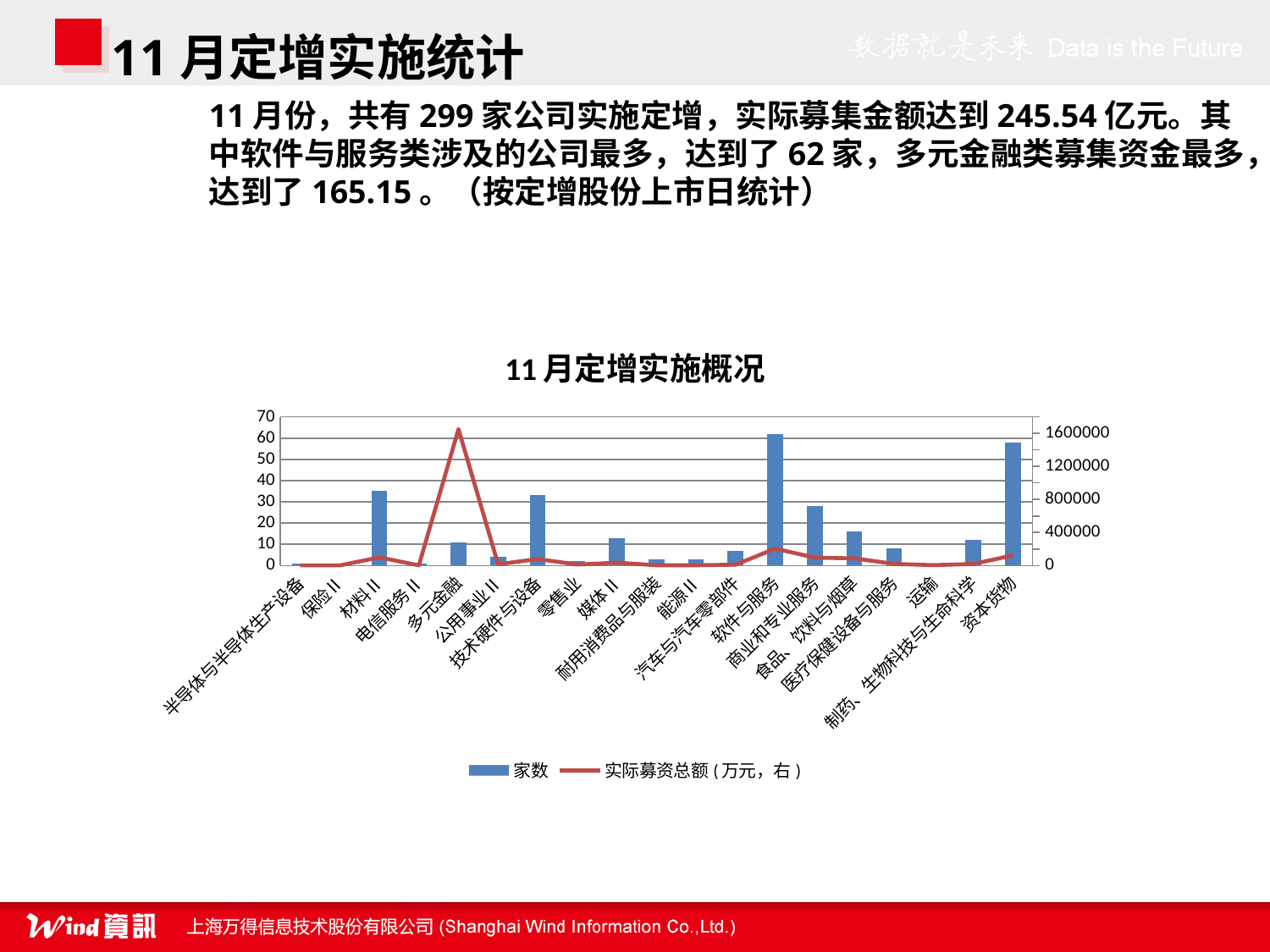
How many series does the chart legend list? 2 How many industry categories are shown on the x axis of the chart? 19 Is the 家数 value for 软件与服务 greater or less than 50? greater Which industry has the highest 家数 bar in the chart? 软件与服务 Is the 实际募资总额 value for 多元金融 greater or less than 1200000? greater Which series is plotted against the right-hand axis? 实际募资总额(万元，右) Which has the larger 家数 value, 材料II or 商业和专业服务? 材料II What is the title of the chart? 11月定增实施概况 Which industry has the highest 实际募资总额 value on the line series? 多元金融 Is the 家数 value for 资本货物 greater or less than 50? greater What kind of chart is shown on the slide? Combination bar and line chart